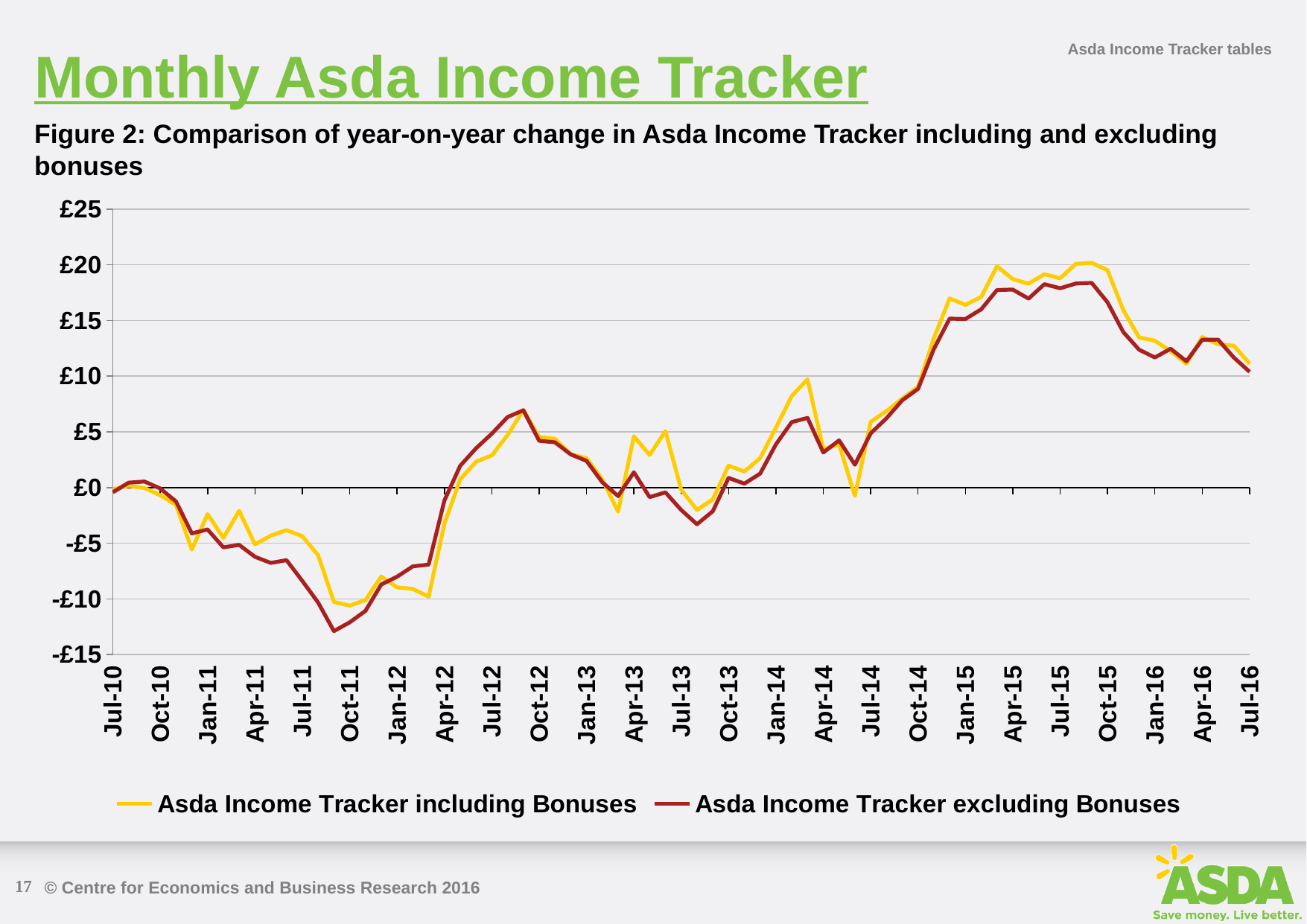
Is the value for Asda Income Tracker including Bonuses at Jul-16 greater or less than £15? less Do both series rise or fall between Jan-12 and Jul-12? rise What is the figure title of the chart? Figure 2: Comparison of year-on-year change in Asda Income Tracker including and excluding bonuses Is the value for Asda Income Tracker excluding Bonuses at Oct-11 greater or less than -£10? less Around which labelled month does the Asda Income Tracker excluding Bonuses line reach its lowest value? Oct-11 At Apr-13, which series has the higher value: including Bonuses or excluding Bonuses? Asda Income Tracker including Bonuses Which series is drawn in yellow? Asda Income Tracker including Bonuses Is the value for Asda Income Tracker including Bonuses at Oct-15 greater or less than £15? greater At Oct-11, which series has the higher value: including Bonuses or excluding Bonuses? Asda Income Tracker including Bonuses What kind of chart is shown on the slide? Line chart How many series does the legend list? 2